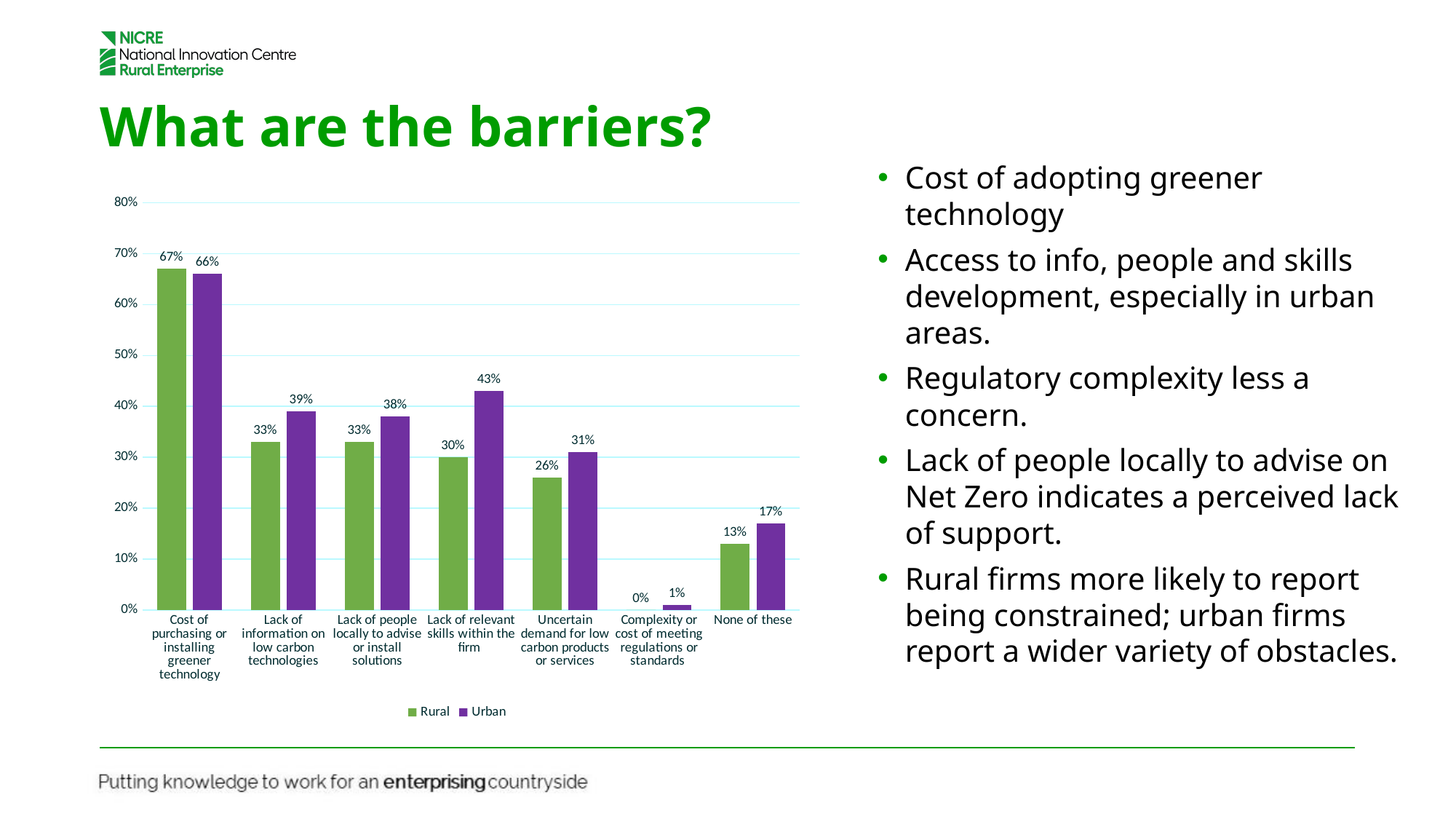
What is the Rural value for 'Uncertain demand for low carbon products or services'? 26% What is the Rural value for 'Cost of purchasing or installing greener technology'? 67% How many categories are shown on the x axis? 7 What is the difference between the Urban and Rural values for 'Lack of relevant skills within the firm'? 13% Which category has the highest Urban value? Cost of purchasing or installing greener technology Which colour represents the Urban series in the chart? Purple Which category has the lowest Rural value? Complexity or cost of meeting regulations or standards What is the Urban value for 'Lack of relevant skills within the firm'? 43% For 'None of these', which series has the larger value, Rural or Urban? Urban What kind of chart is shown on the slide? Bar chart Is the Urban value for 'Lack of information on low carbon technologies' greater or less than 30%? greater How many series does the legend list? 2